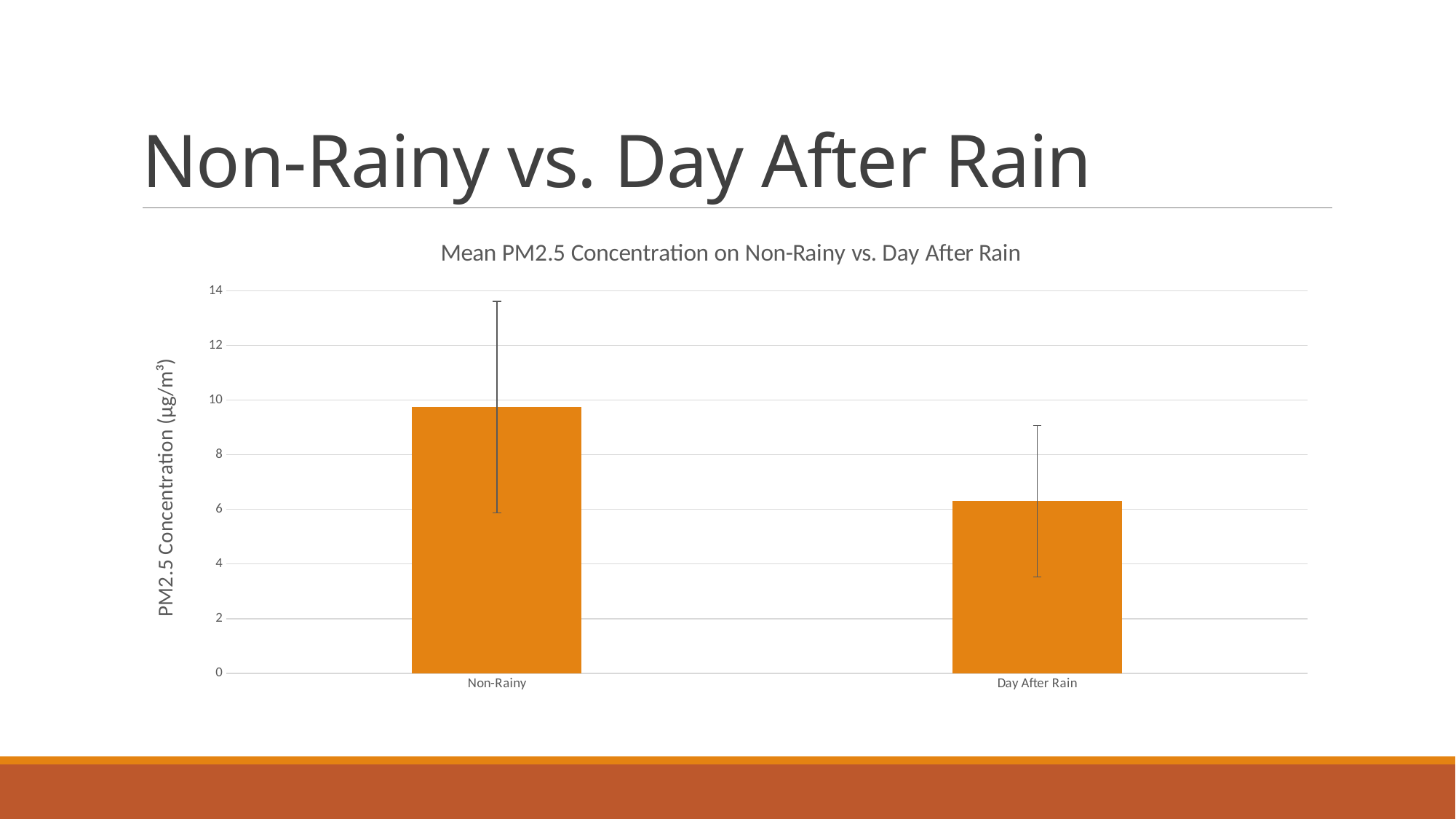
Is the value for Day After Rain greater or less than 8? less Is the value for Day After Rain greater or less than 4? greater Which is larger, the value for Non-Rainy or the value for Day After Rain? Non-Rainy Is the value for Non-Rainy greater or less than 8? greater Which category has the highest mean PM2.5 concentration? Non-Rainy Which category has the lowest mean PM2.5 concentration? Day After Rain How many categories are plotted in the chart? 2 What kind of chart is shown on the slide? bar chart What is the label on the vertical axis of the chart? PM2.5 Concentration (µg/m³) What is the title of the chart? Mean PM2.5 Concentration on Non-Rainy vs. Day After Rain